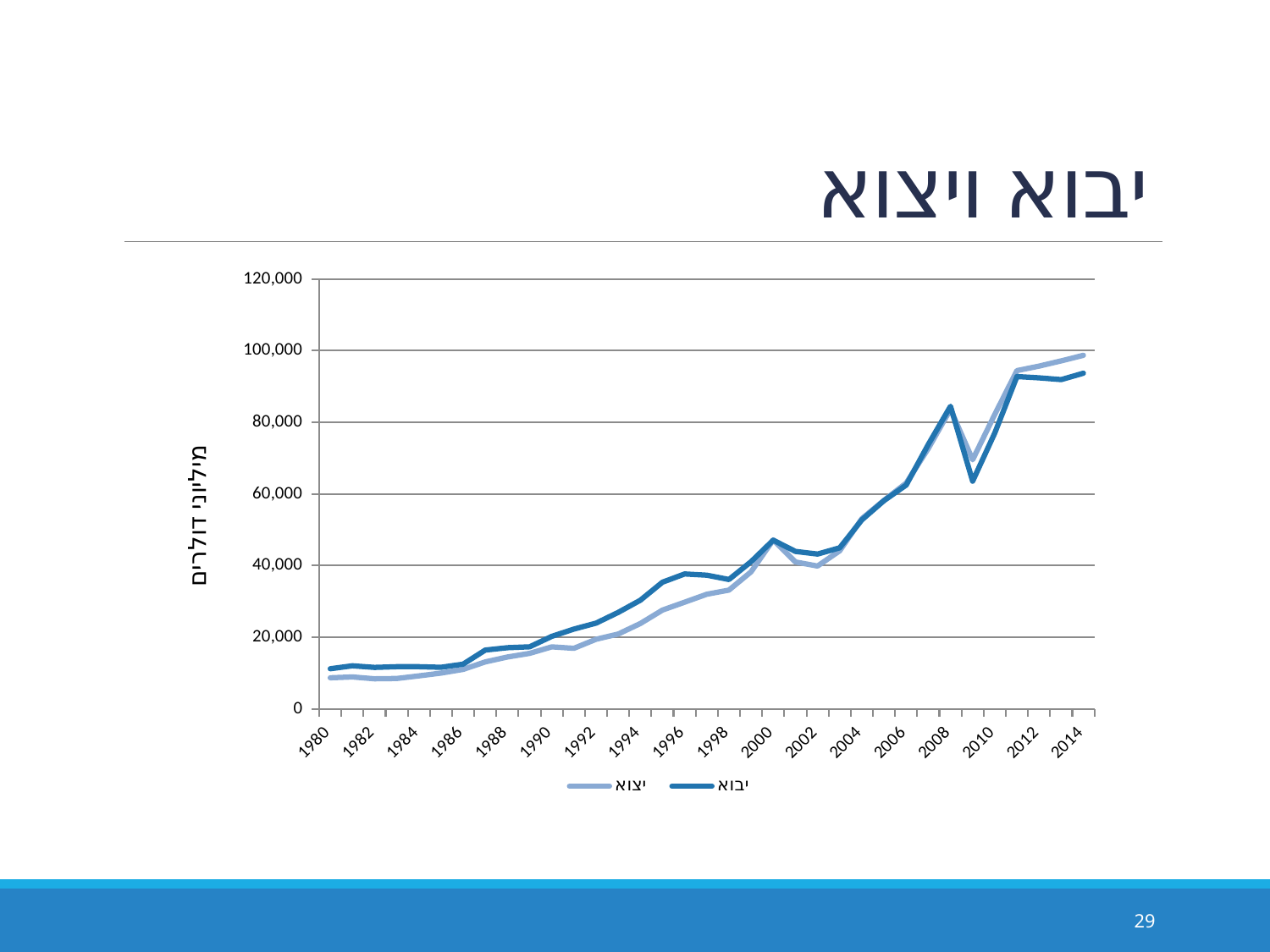
What kind of chart is shown on the slide? line chart Is the value for יצוא in 1980 greater or less than 20,000? less Is the value for יבוא in 2000 greater or less than 40,000? greater What are the two series named in the legend? יצוא and יבוא Do the values for יבוא generally rise or fall from 1980 to 2014? rise Is the value for יצוא in 2012 greater or less than 80,000? greater In 1996, which series has the larger value, יבוא or יצוא? יבוא How many year labels are shown on the x axis? 18 How many series does the legend list? 2 What is the label on the vertical axis? מיליוני דולרים